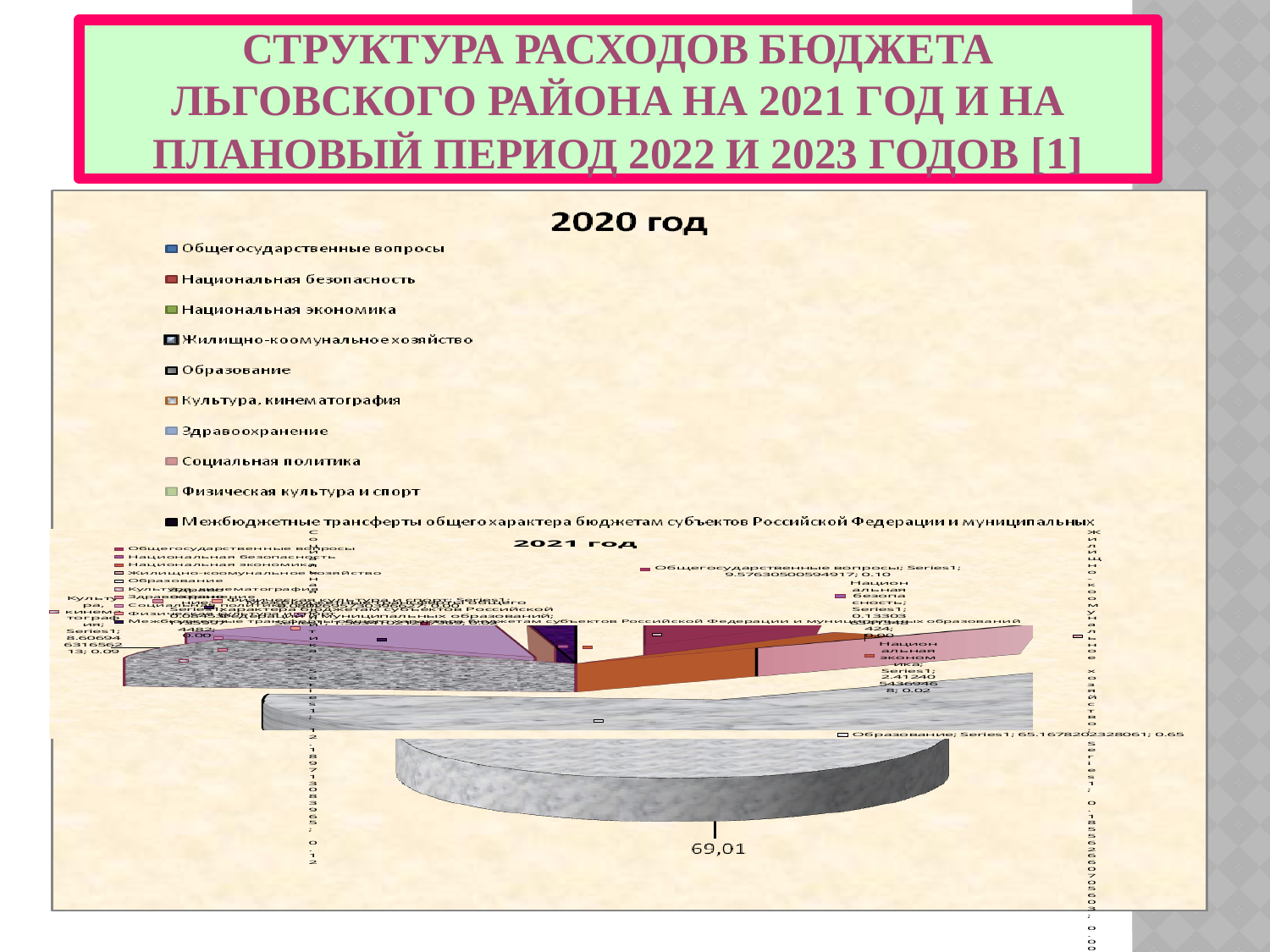
In the "2021 год" chart, what share is printed for Общегосударственные вопросы? 0.10 In the "2021 год" chart, which has the larger share: Образование or Культура, кинематография? Образование In the "2021 год" chart, what is the difference between the shares of Образование and Общегосударственные вопросы? 0.55 In the "2021 год" chart, which has the larger share: Общегосударственные вопросы or Национальная экономика? Общегосударственные вопросы What is the title of the upper chart on the slide? 2020 год How many entries does the legend of the "2020 год" chart list? 10 In the "2020 год" chart, what value is printed on the data label below the large grey slice? 69,01 In the "2021 год" chart, which category has the largest share? Образование In the "2021 год" chart, what share is printed for Образование? 0.65 What kind of chart is the "2020 год" chart? pie chart In the "2021 год" chart, what share is printed for Национальная экономика? 0.02 In the "2020 год" chart, what is the first entry listed in the legend? Общегосударственные вопросы